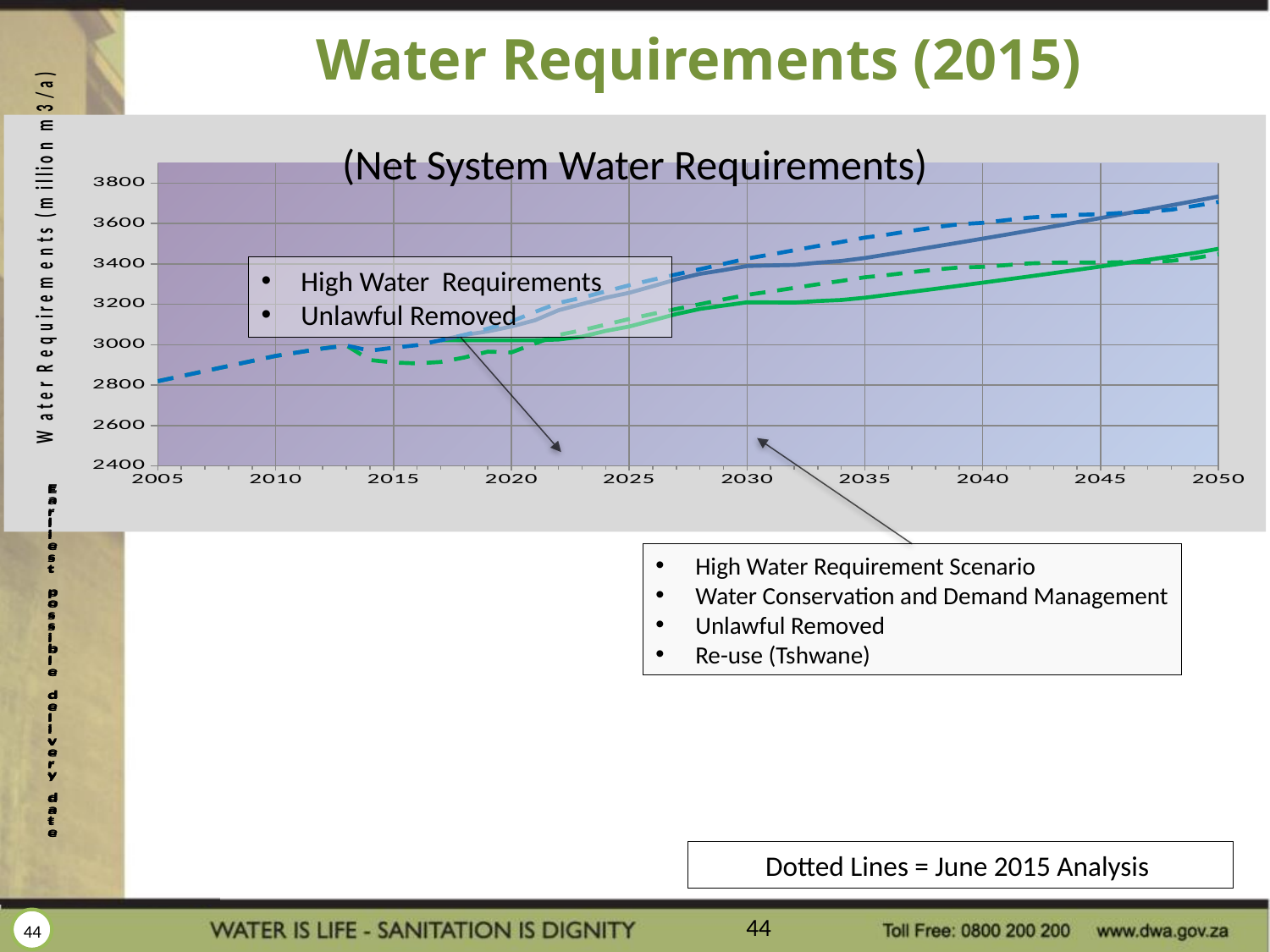
How many lines are plotted on the chart? 4 Is the value of the solid blue line at 2050 greater or less than 3600? greater Is the value of the dashed blue line at 2030 greater or less than 3200? greater How many year labels are shown along the x axis? 10 At 2035, which is higher: the dashed blue line or the solid blue line? dashed blue line What is the title printed inside the chart area? (Net System Water Requirements) Is the value of the dashed green line at 2015 greater or less than 3000? less What kind of chart is shown on the slide? line chart At 2050, which is higher: the solid blue line or the solid green line? solid blue line What does the y-axis label say? Water Requirements (million m3/a) Does the solid blue line rise or fall between 2015 and 2050? rise